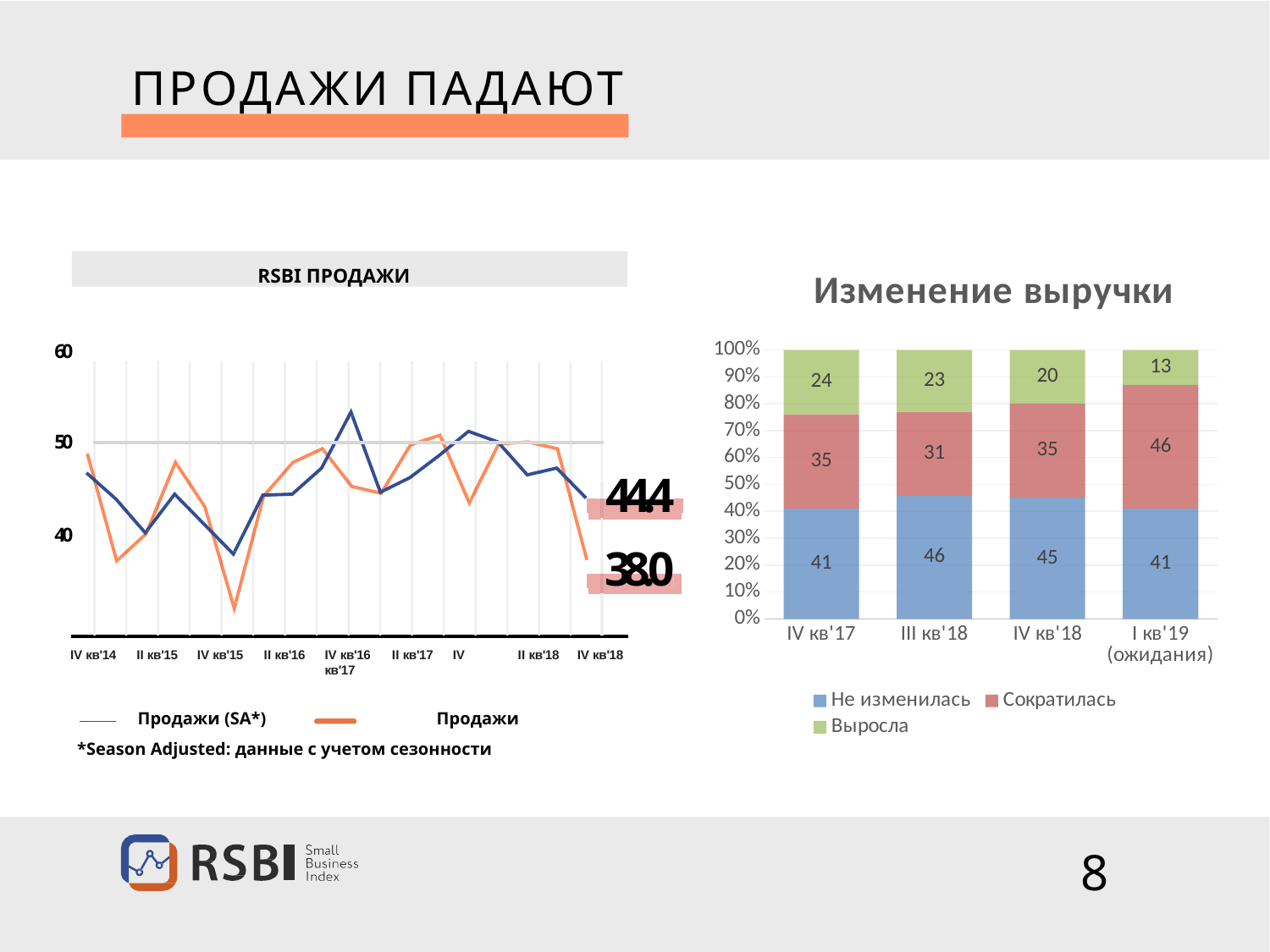
In the 'RSBI ПРОДАЖИ' chart, what is the final labelled value of the 'Продажи' series? 38.0 In the 'Изменение выручки' chart, which category has the highest value for 'Сократилась'? I кв'19 (ожидания) In the 'Изменение выручки' chart, what is the value for 'Не изменилась' in III кв'18? 46 In the 'Изменение выручки' chart, which category has the lowest value for 'Выросла'? I кв'19 (ожидания) In the 'RSBI ПРОДАЖИ' chart, is the final value of 'Продажи (SA*)' greater or less than 40? greater How many categories are shown on the x axis of the 'Изменение выручки' chart? 4 In the 'Изменение выручки' chart, what is the value for 'Выросла' in IV кв'17? 24 In the 'Изменение выручки' chart, what is the value for 'Сократилась' in I кв'19 (ожидания)? 46 In the 'Изменение выручки' chart, what is the difference between the 'Сократилась' values for I кв'19 (ожидания) and IV кв'18? 11 In the 'Изменение выручки' chart, is the 'Не изменилась' value larger in III кв'18 or in IV кв'17? III кв'18 What kind of chart is 'RSBI ПРОДАЖИ'? line chart How many series does the legend of the 'Изменение выручки' chart list? 3